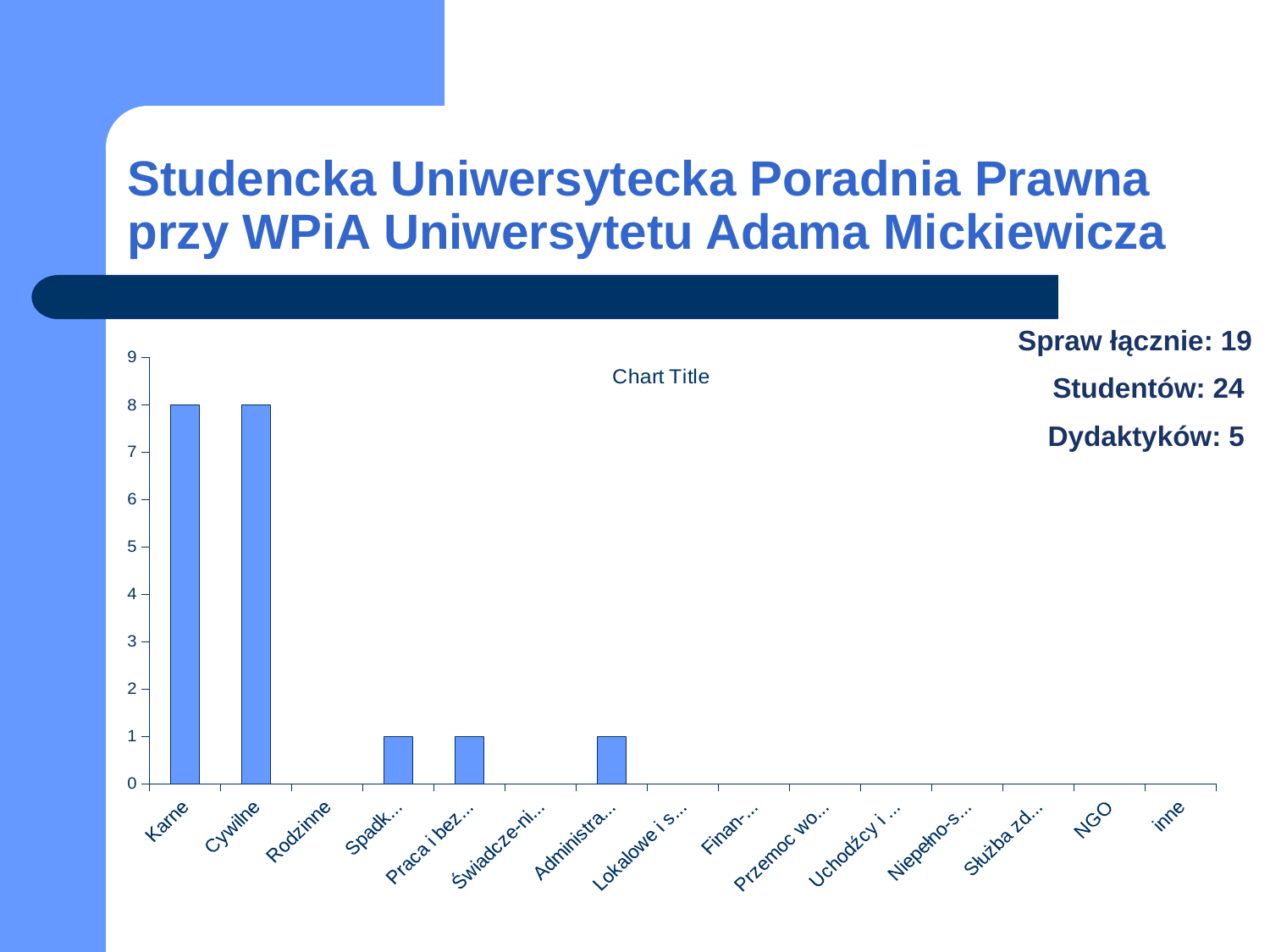
What is the value for inne? 0 What is the value for Cywilne? 8 Is the value for Karne greater or less than 5? greater What is the value for NGO? 0 How many categories are shown on the x axis? 15 Which is larger, the value for Karne or the value for Rodzinne? Karne What is the title of the chart? Chart Title What is the value for Karne? 8 What is the value for Rodzinne? 0 What kind of chart is shown on the slide? bar chart What is the highest value shown on the y axis? 9 What is the difference between the value for Cywilne and the value for NGO? 8